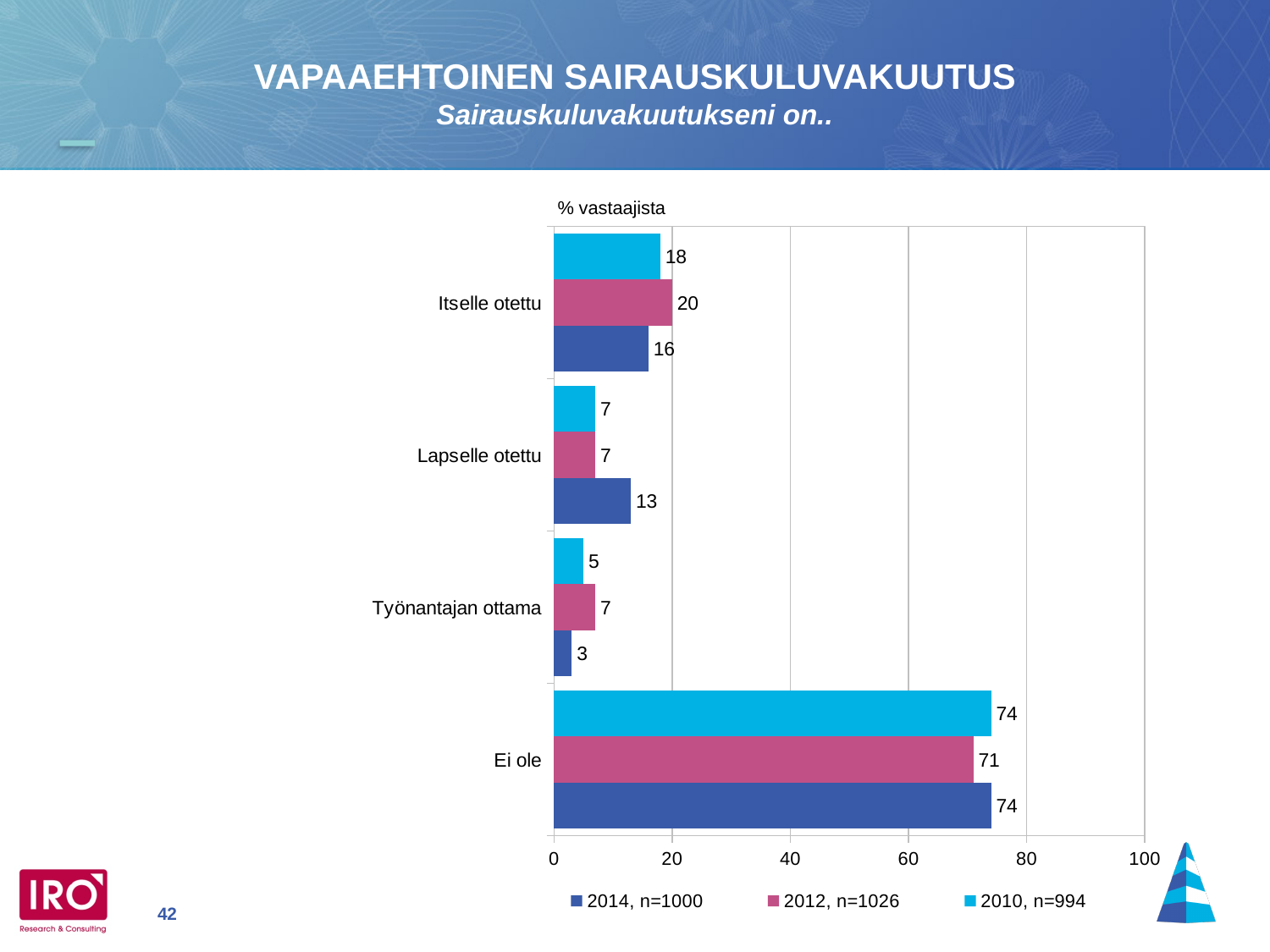
Which category has the highest value in the 2010, n=994 series? Ei ole What kind of chart is shown on the slide? Bar chart How many categories are shown on the chart? 4 What is the value for 'Työnantajan ottama' in the 2014, n=1000 series? 3 Which category has the lowest value in the 2014, n=1000 series? Työnantajan ottama Is the value for 'Ei ole' in the 2012, n=1026 series greater or less than 60? greater What is the value for 'Lapselle otettu' in the 2010, n=994 series? 7 What is the difference between the 2012, n=1026 and 2014, n=1000 values for 'Itselle otettu'? 4 What is the value for 'Itselle otettu' in the 2014, n=1000 series? 16 Which is larger for 'Lapselle otettu': the 2014, n=1000 value or the 2012, n=1026 value? 2014, n=1000 What is the value for 'Ei ole' in the 2012, n=1026 series? 71 How many series does the legend list? 3